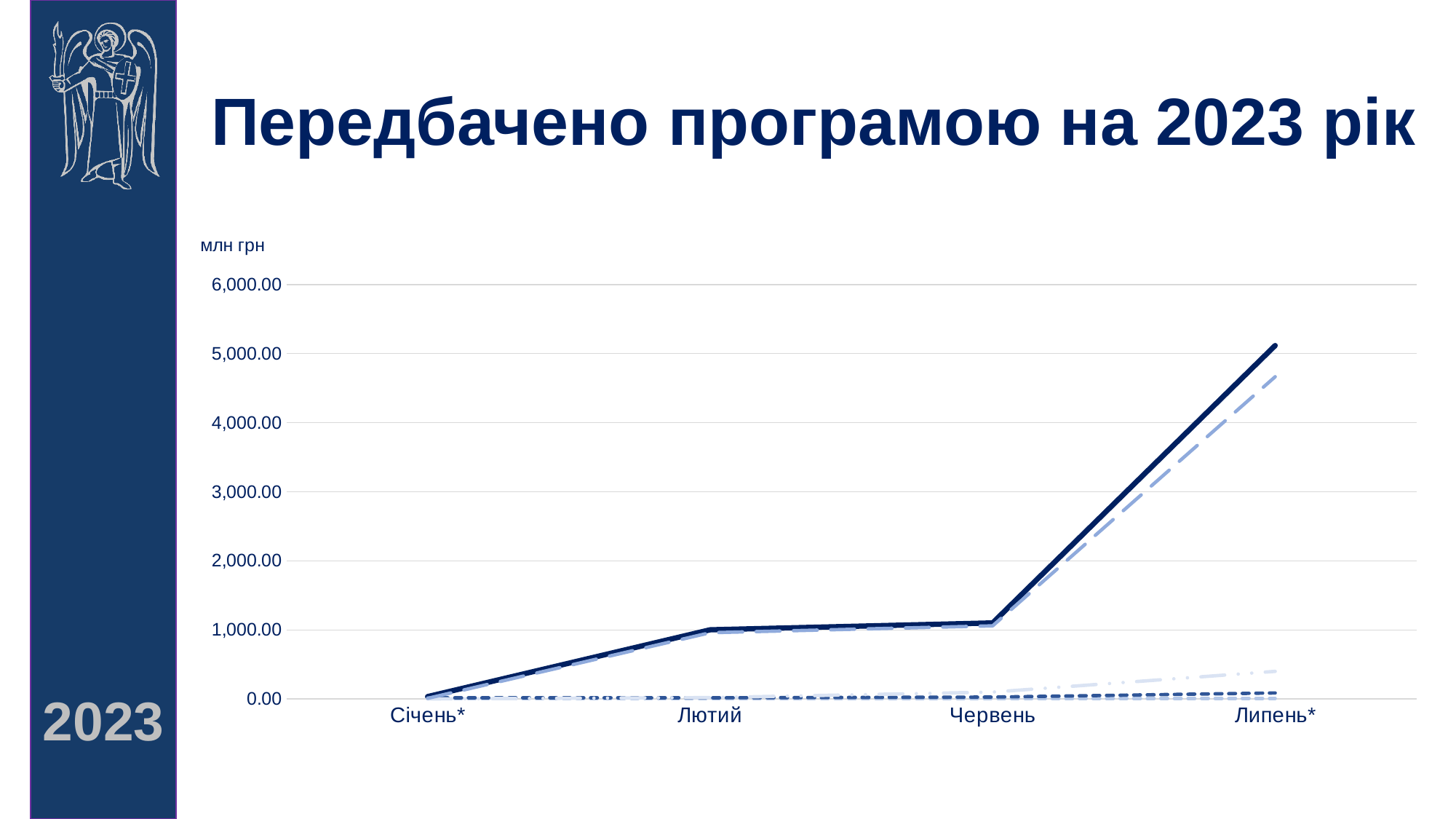
What is the title of the slide containing the chart? Передбачено програмою на 2023 рік At which category does the solid dark line have its lowest value? Січень* Is the value of the solid dark line at Червень greater or less than 2,000.00? less For the solid dark line, which category has the larger value: Лютий or Липень*? Липень* Is the value of the solid dark line at Січень* greater or less than 1,000.00? less How many categories are shown on the x axis of the chart? 4 What type of chart is shown on the slide? line chart Is the value of the solid dark line at Липень* greater or less than 4,000.00? greater Does the solid dark line rise or fall from Січень* to Липень*? rises At which category does the solid dark line reach its highest value? Липень* What unit label is shown above the vertical axis of the chart? млн грн